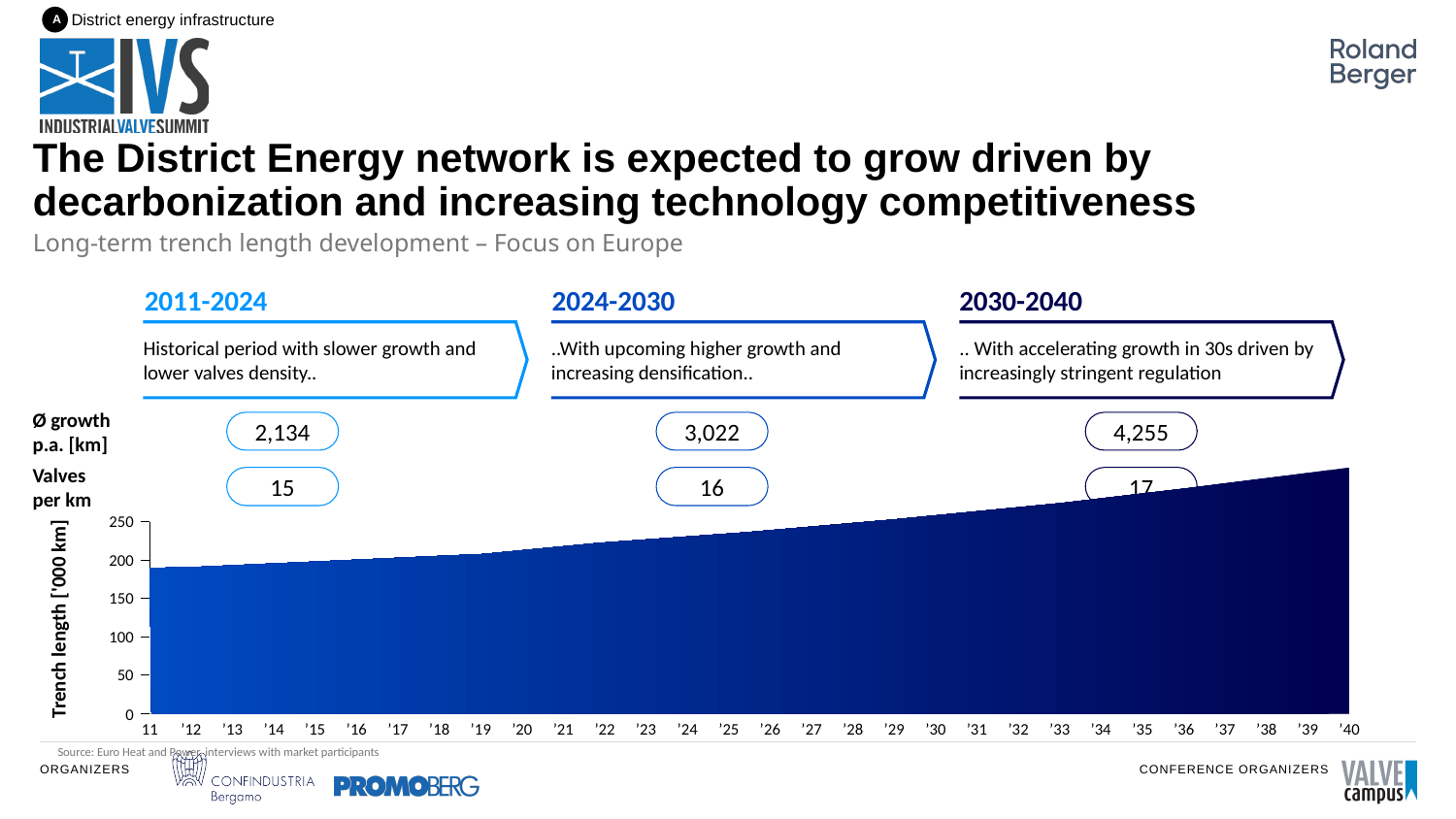
How many valves per km are shown for the 2011-2024 period? 15 Is the trench length value for '38 greater or less than 250? greater What is the average growth p.a. [km] shown for the 2030-2040 period? 4,255 What is the difference between the average growth p.a. [km] for 2030-2040 and for 2011-2024? 2,121 How many years are labelled on the x axis of the chart? 30 Does the trench length rise or fall from '11 to '40? Rise Is the trench length value for '11 greater or less than 150? greater What is the label of the y axis of the chart? Trench length ['000 km] Is the trench length value for '20 greater or less than 250? less Which period has the higher average growth p.a. [km], 2011-2024 or 2024-2030? 2024-2030 What kind of chart is shown on the slide? Area chart What is the average growth p.a. [km] shown for the 2024-2030 period? 3,022